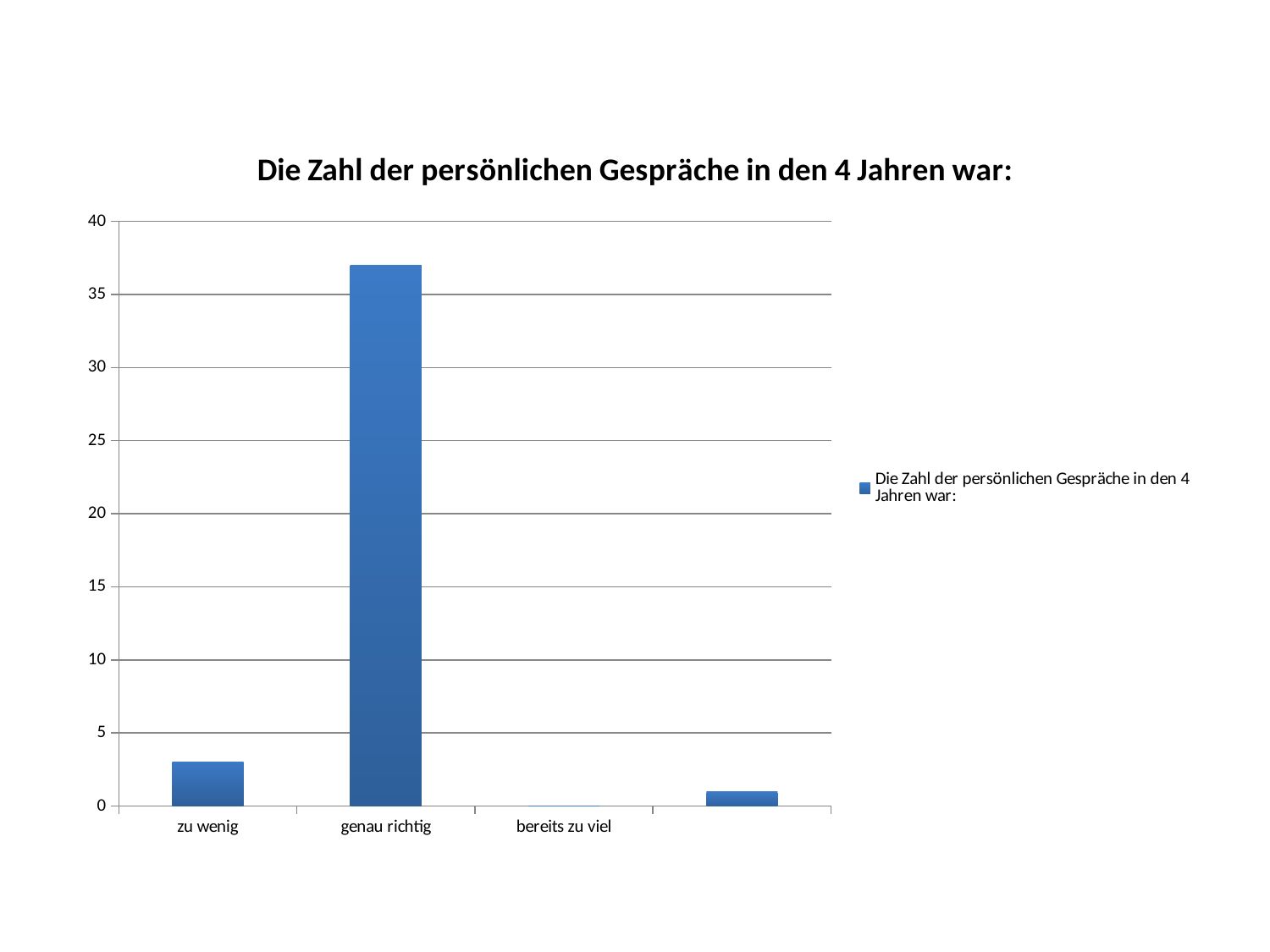
What kind of chart is shown on the slide? bar chart Is the value for genau richtig greater or less than 40? less Which is larger, the value for zu wenig or the value for bereits zu viel? zu wenig How many series does the legend list? 1 What is the title of the chart? Die Zahl der persönlichen Gespräche in den 4 Jahren war: Is the value for zu wenig greater or less than 5? less Which labelled category has the lowest value? bereits zu viel What is the highest value shown on the vertical axis? 40 Which category has the highest value? genau richtig Is the value for genau richtig greater or less than 35? greater Which is larger, the value for genau richtig or the value for zu wenig? genau richtig